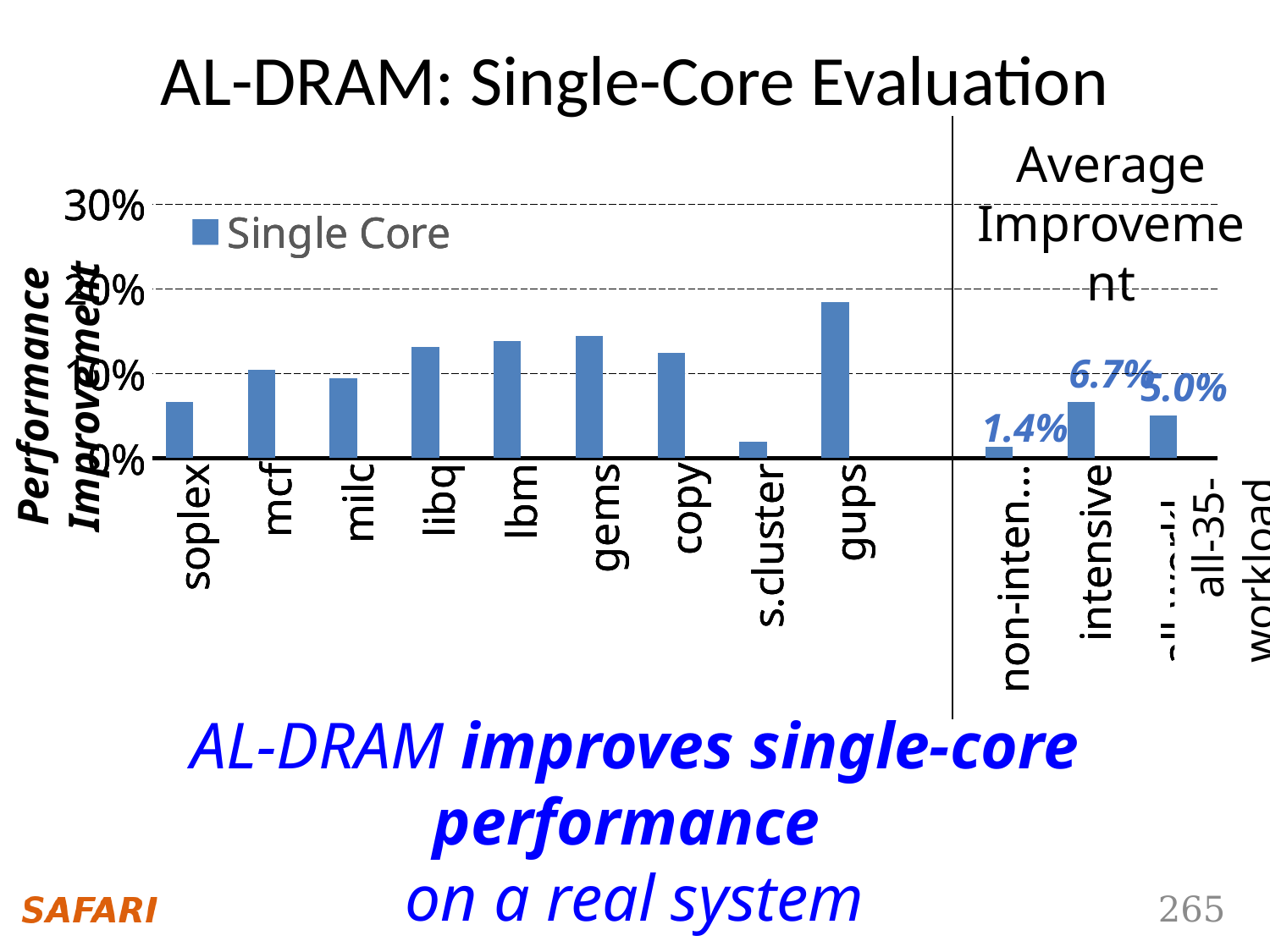
Is the value for soplex greater or less than 10%? less What is the data label shown for the intensive category? 6.7% What is the data label shown for the all-35-workload category? 5.0% What is the data label shown for the non-intensive category? 1.4% What kind of chart is shown on the slide? bar chart Which is larger, the value for gups or the value for soplex? gups How many bars are plotted in the chart? 12 Which category has the tallest bar in the chart? gups What is the difference between the intensive value and the non-intensive value? 5.3% Among the three average-improvement bars (non-intensive, intensive, all-35-workload), which has the lowest value? non-intensive Is the value for gups greater or less than 10%? greater What is the difference between the intensive value and the all-35-workload value? 1.7%